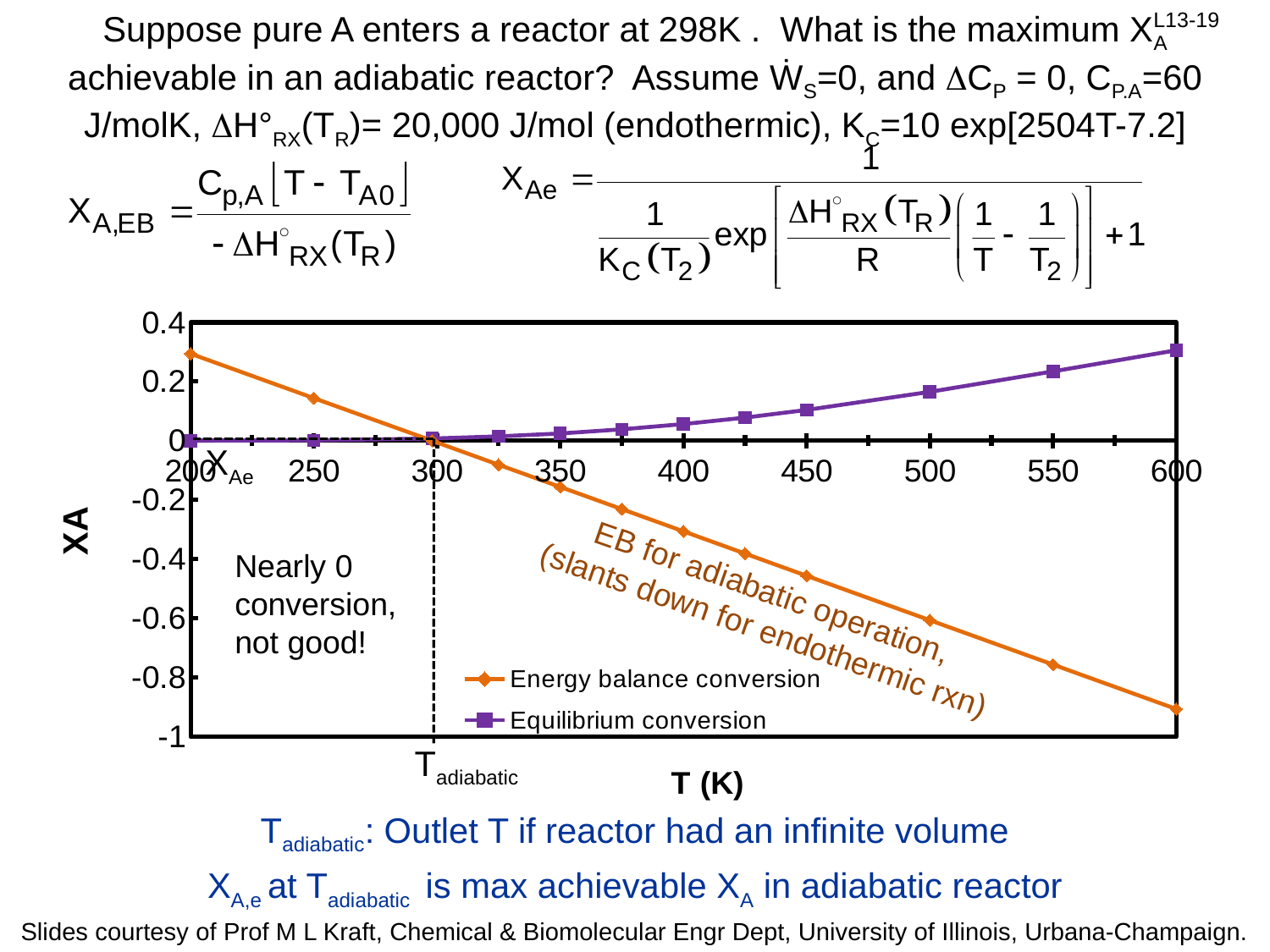
How many series does the chart's legend list? 2 What are the two series named in the chart's legend? Energy balance conversion; Equilibrium conversion Does the Energy balance conversion series rise or fall as T increases? fall Is the Energy balance conversion value at 200 K greater or less than 0.2? greater Is the Equilibrium conversion value at 600 K greater or less than 0.2? greater What is the label of the chart's x axis? T (K) At 200 K, which series has the higher value, Energy balance conversion or Equilibrium conversion? Energy balance conversion Is the Energy balance conversion value at 400 K greater or less than -0.2? less At 600 K, which series has the higher value, Energy balance conversion or Equilibrium conversion? Equilibrium conversion What kind of chart is shown on the slide? line chart Does the Equilibrium conversion series rise or fall as T increases? rise